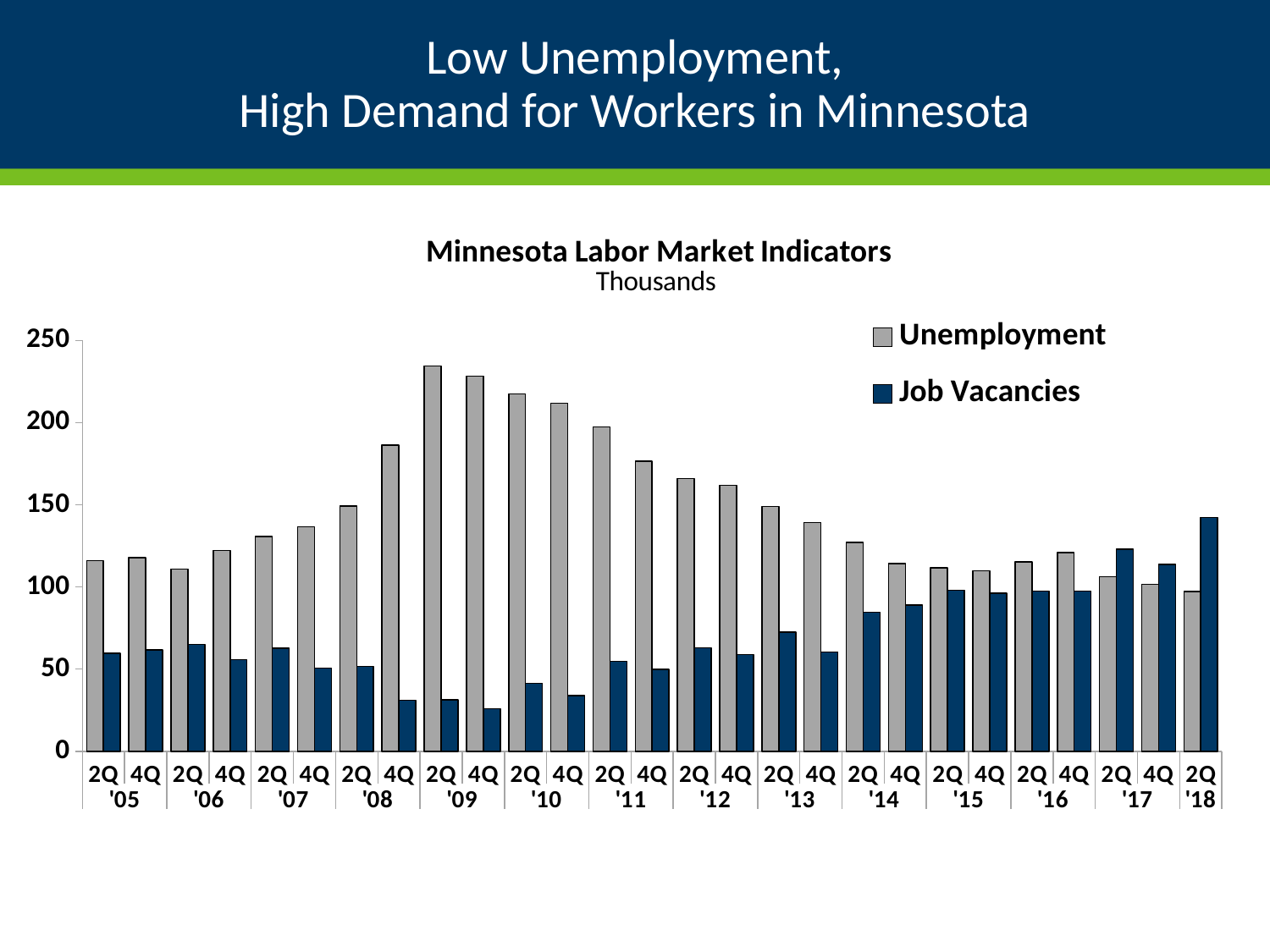
What kind of chart is shown on the slide? Bar chart In which quarter is Unemployment highest? 2Q '09 What is the title of the chart? Minnesota Labor Market Indicators Does Unemployment rise or fall from 2Q '09 to 2Q '14? Fall In what units are the values on the chart expressed, according to the subtitle? Thousands In 2Q '18, which is larger: Unemployment or Job Vacancies? Job Vacancies Is the Unemployment value for 2Q '09 greater or less than 200? greater In which quarter are Job Vacancies highest? 2Q '18 Is the Job Vacancies value for 4Q '09 greater or less than 50? less Is the Job Vacancies value for 2Q '17 greater or less than 100? greater In which quarter are Job Vacancies lowest? 4Q '09 How many series does the legend list? 2